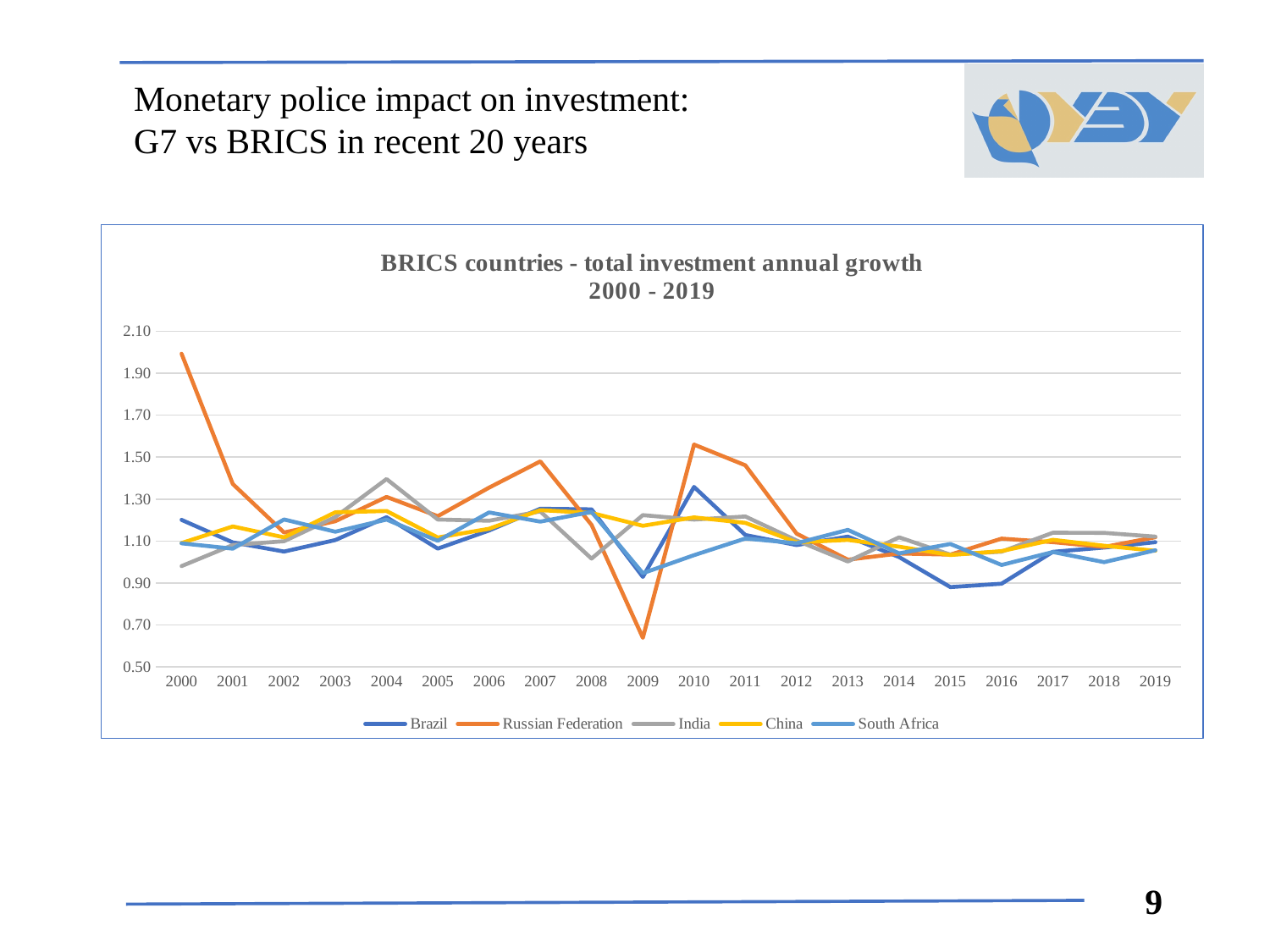
What is the title of the chart? BRICS countries - total investment annual growth 2000 - 2019 Which country has the lowest value in 2009? Russian Federation What kind of chart is shown on the slide? Line chart Is the value for India in 2000 greater or less than 1.10? less Does the Russian Federation line rise or fall from 2000 to 2002? Fall In 2004, which is larger: the value for India or the value for Brazil? India Which country has the highest value in 2000? Russian Federation How many series does the legend list? 5 Is the value for Russian Federation in 2009 greater or less than 0.70? less Is the value for India in 2004 greater or less than 1.30? greater How many years are shown on the x axis? 20